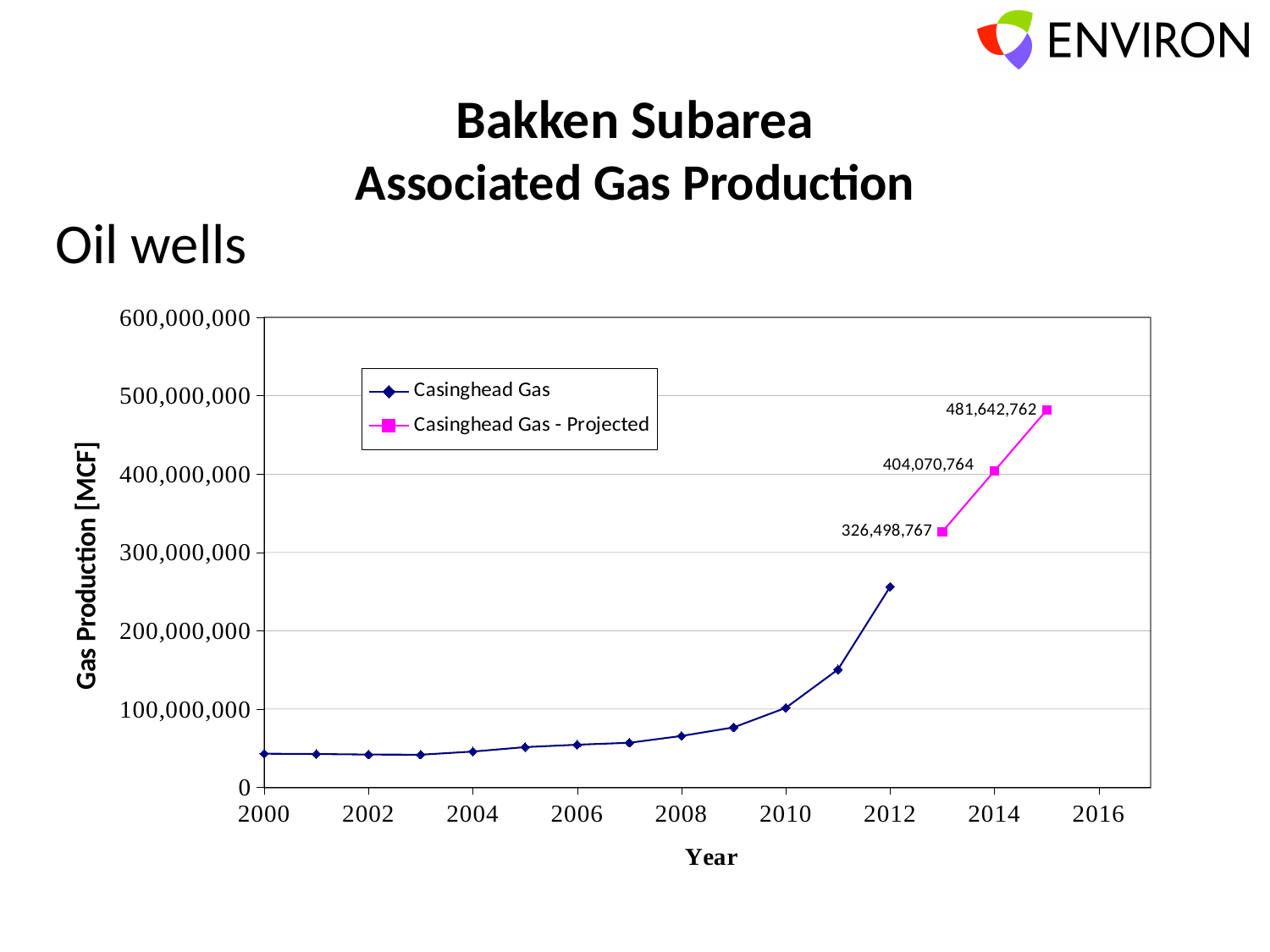
Is the Casinghead Gas production in 2000 greater or less than 100,000,000? less Does the Casinghead Gas production rise or fall from 2008 to 2012? Rise What is the projected Casinghead Gas production for 2014? 404,070,764 How many series does the legend list? 2 What is the projected Casinghead Gas production for 2013? 326,498,767 What kind of chart is shown on the slide? Line chart What is the projected Casinghead Gas production for 2015? 481,642,762 Which year has the highest projected Casinghead Gas production? 2015 What is the difference between the projected Casinghead Gas production in 2015 and in 2014? 77,571,998 Which year has the lowest projected Casinghead Gas production? 2013 Is the Casinghead Gas production in 2012 greater or less than 200,000,000? greater What is the difference between the projected Casinghead Gas production in 2015 and in 2013? 155,143,995